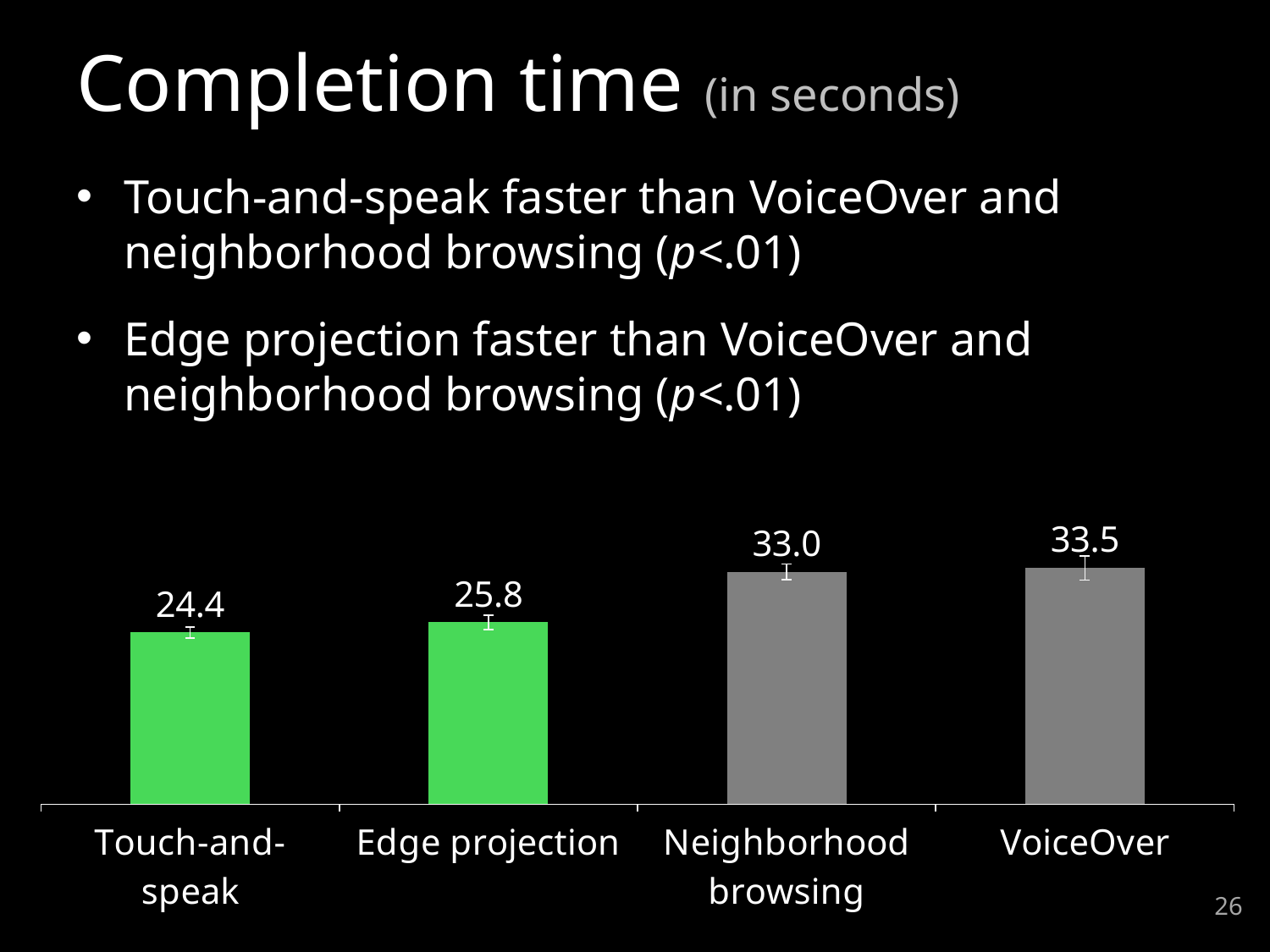
What is the difference in completion time between VoiceOver and Touch-and-speak? 9.1 What is the completion time for Touch-and-speak? 24.4 What is the completion time for Neighborhood browsing? 33.0 How many categories are shown in the chart? 4 What is the completion time for VoiceOver? 33.5 What is the completion time for Edge projection? 25.8 What is the difference in completion time between Neighborhood browsing and Edge projection? 7.2 Which category has the lowest completion time? Touch-and-speak Which has a larger completion time, Edge projection or Neighborhood browsing? Neighborhood browsing Which category has the highest completion time? VoiceOver What colour are the bars for Touch-and-speak and Edge projection? Green What kind of chart is shown on the slide? Bar chart